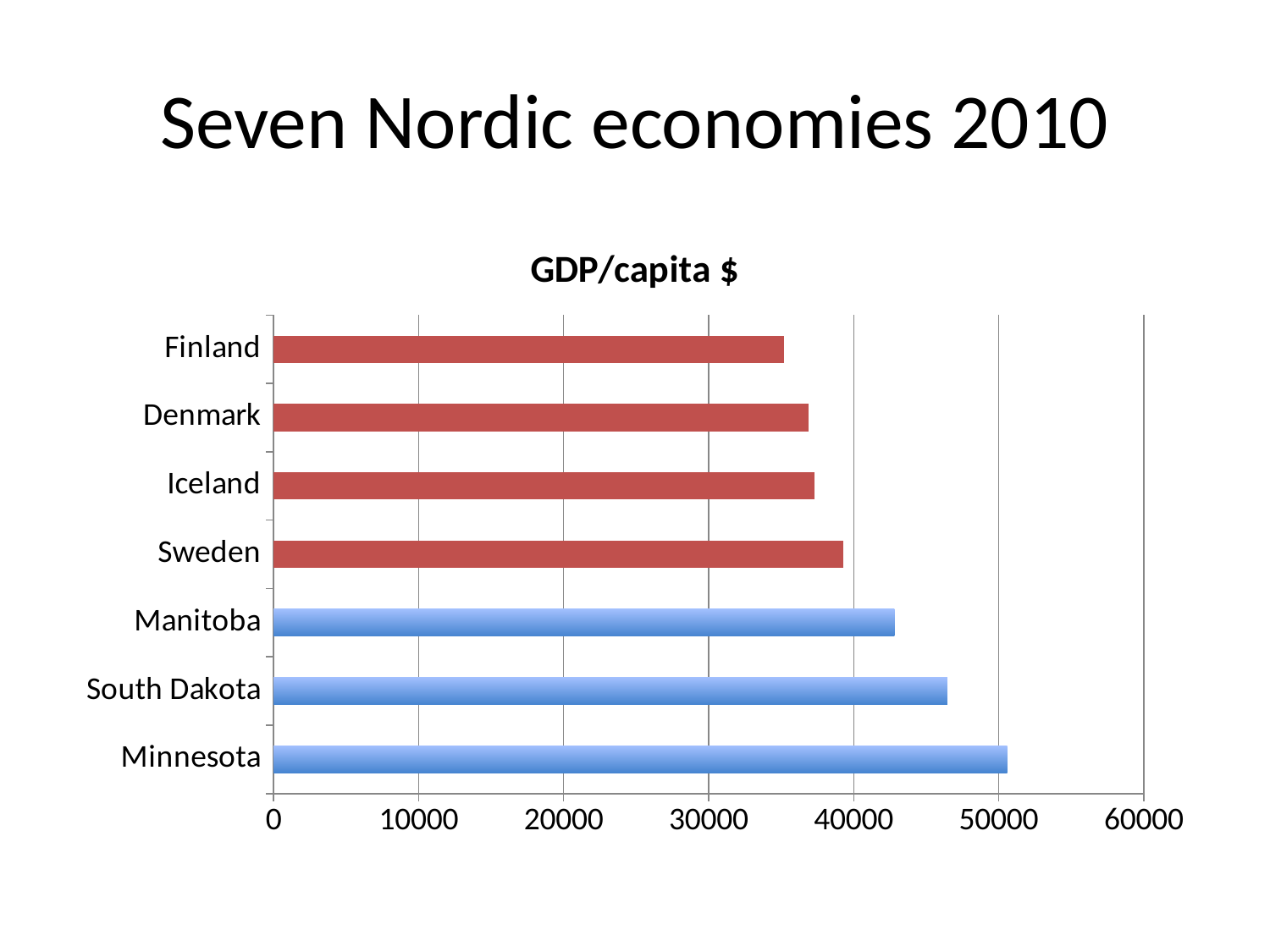
Is the GDP/capita $ value for Iceland greater or less than 40000? less What kind of chart is shown on the slide? bar chart Is the GDP/capita $ value for Finland greater or less than 30000? greater Which category has the lowest GDP/capita $? Finland Which has a higher GDP/capita $, Manitoba or Sweden? Manitoba Is the GDP/capita $ value for Minnesota greater or less than 40000? greater How many categories are plotted in the GDP/capita $ chart? 7 What is the title of the chart? GDP/capita $ Which has a higher GDP/capita $, South Dakota or Manitoba? South Dakota Which category has the highest GDP/capita $? Minnesota